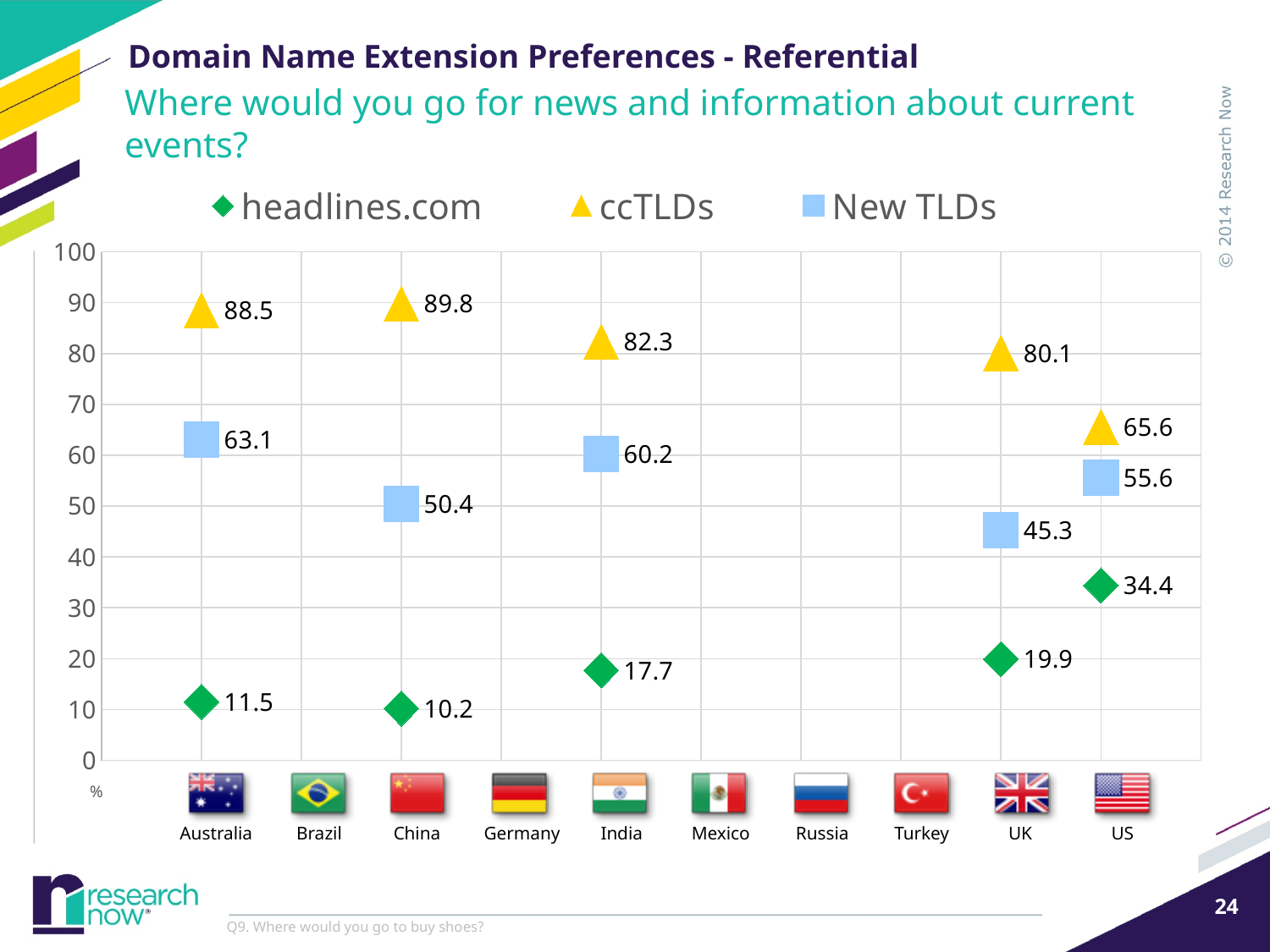
Which country has the lowest headlines.com value? China How many series does the legend list? 3 Which marker shape represents the ccTLDs series in the legend? Yellow triangle What is the ccTLDs value for China? 89.8 Which is larger for the US: the New TLDs value or the headlines.com value? New TLDs How many countries are shown along the x axis? 10 Which country has the lowest ccTLDs value? US What is the difference between the ccTLDs and New TLDs values for India? 22.1 What is the headlines.com value for the US? 34.4 Which country has the highest ccTLDs value? China What is the New TLDs value for the UK? 45.3 What is the New TLDs value for Australia? 63.1